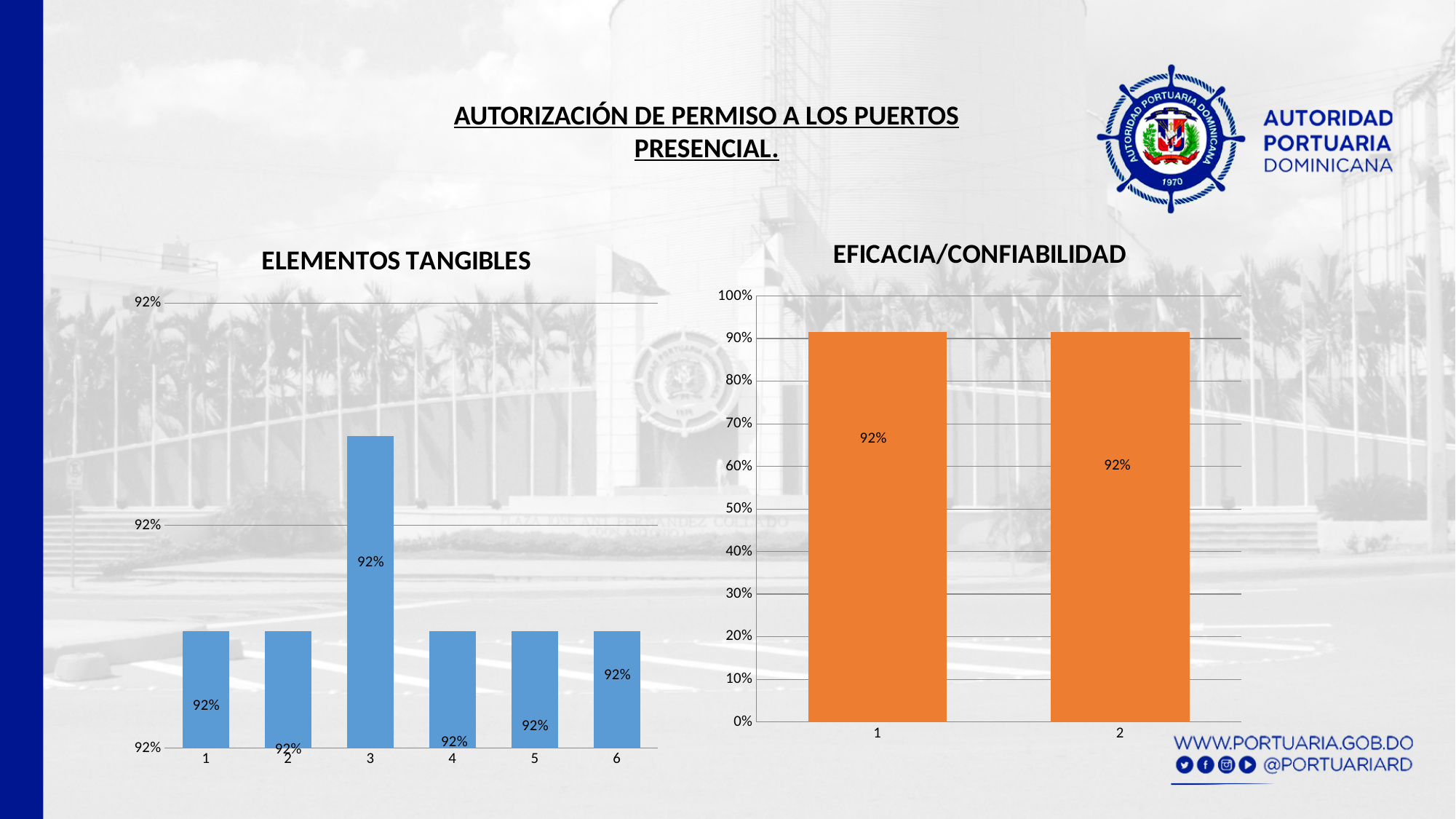
In the EFICACIA/CONFIABILIDAD chart, how many bars are plotted? 2 In the EFICACIA/CONFIABILIDAD chart, what is the value for category 1? 92% In the EFICACIA/CONFIABILIDAD chart, what is the value for category 2? 92% In the EFICACIA/CONFIABILIDAD chart, what is the difference between the values for category 1 and category 2? 0% In the ELEMENTOS TANGIBLES chart, how many bars are plotted? 6 In the EFICACIA/CONFIABILIDAD chart, is the value for category 2 greater or less than 100%? less What kind of chart is the EFICACIA/CONFIABILIDAD chart? bar chart In the EFICACIA/CONFIABILIDAD chart, is the value for category 1 greater or less than 50%? greater What colour are the bars in the EFICACIA/CONFIABILIDAD chart? orange What kind of chart is the ELEMENTOS TANGIBLES chart? bar chart In the ELEMENTOS TANGIBLES chart, what is the value for category 6? 92% In the ELEMENTOS TANGIBLES chart, what is the value for category 3? 92%